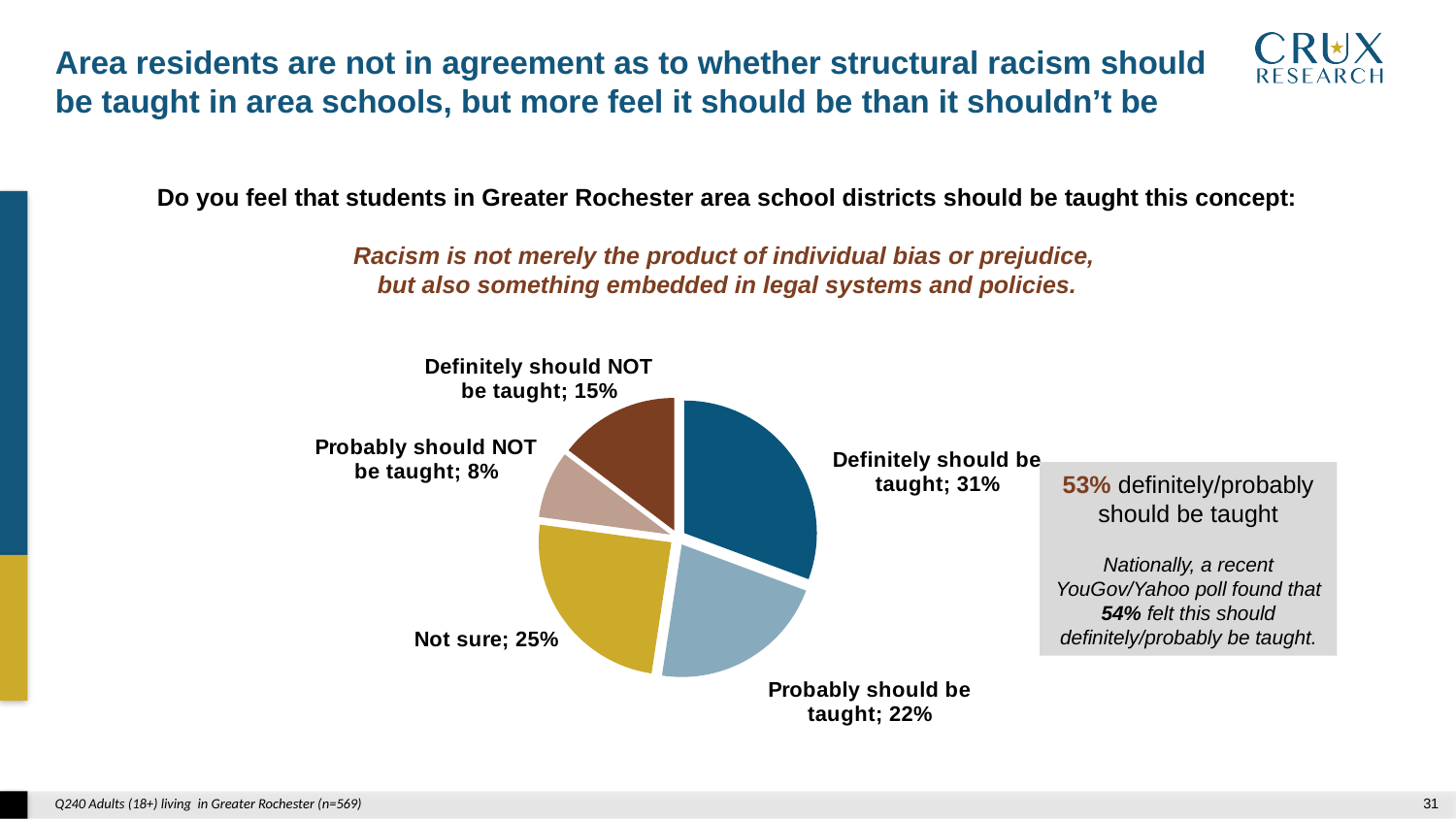
Which response category has the smallest share of the pie? Probably should NOT be taught Which is larger: the share for 'Not sure' or the share for 'Probably should be taught'? Not sure What percentage of respondents said the concept definitely should NOT be taught? 15% What percentage of respondents said students definitely should be taught this concept? 31% Which response category has the largest share of the pie? Definitely should be taught What is the combined percentage for 'Definitely should be taught' and 'Probably should be taught'? 53% What percentage of respondents said the concept probably should NOT be taught? 8% What kind of chart is shown on the slide? pie chart What percentage of respondents said students probably should be taught this concept? 22% What is the difference in percentage points between 'Definitely should be taught' and 'Definitely should NOT be taught'? 16 What percentage of respondents were not sure? 25% How many response categories are shown in the pie chart? 5